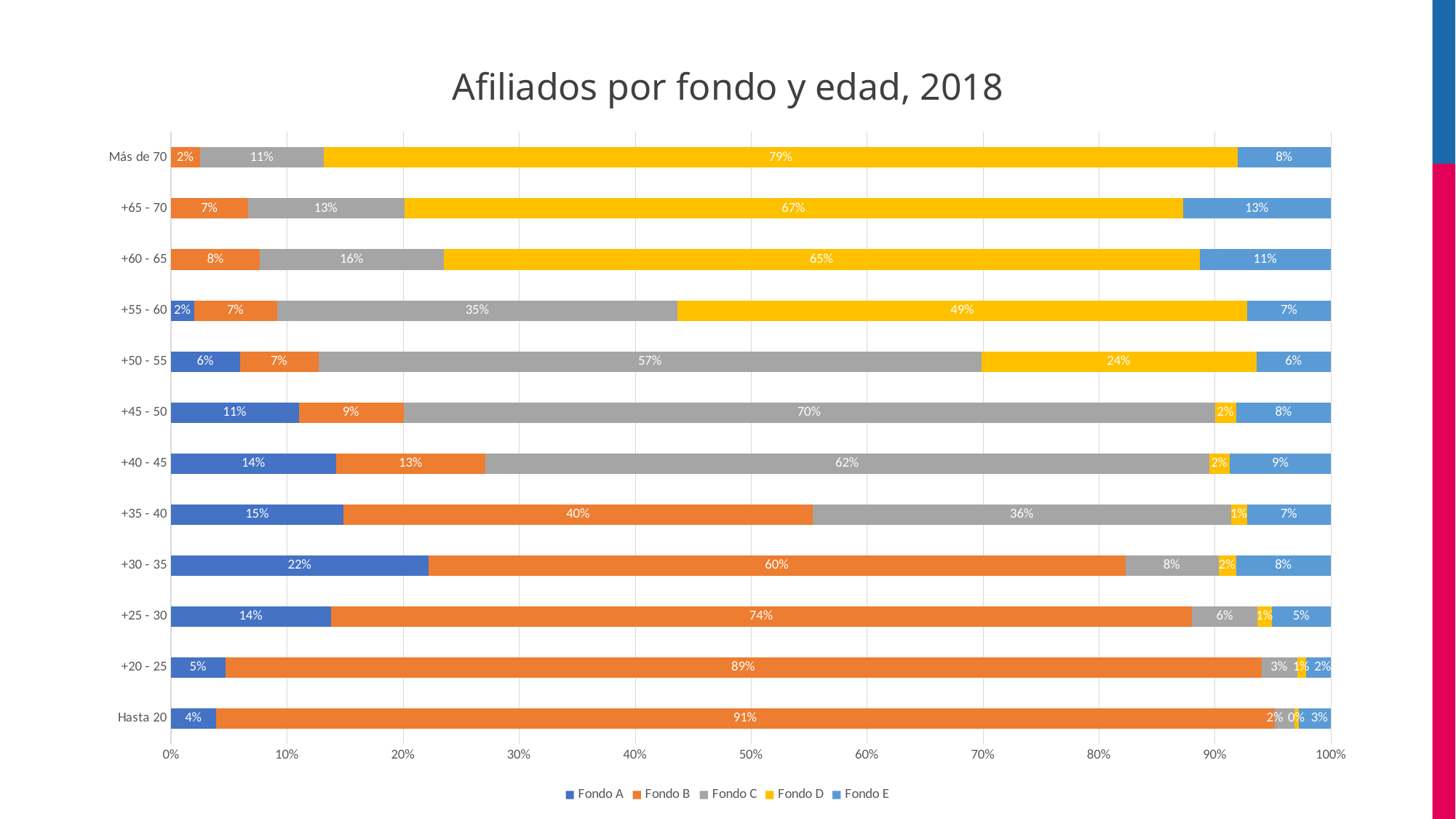
In the '+55 - 60' category, which is larger: Fondo C or Fondo D? Fondo D Which age category has the highest value for Fondo A? +30 - 35 What is the value for Fondo D in the 'Más de 70' category? 79% What is the value for Fondo B in the 'Hasta 20' category? 91% What is the value for Fondo C in the '+50 - 55' category? 57% What type of chart is shown on the slide? Stacked bar chart How many age categories are shown on the chart? 12 Which age category has the highest value for Fondo D? Más de 70 Which series is shown in orange in the legend? Fondo B How many series does the legend list? 5 What is the title of the chart? Afiliados por fondo y edad, 2018 What is the difference between Fondo B and Fondo C in the '+35 - 40' category? 4%